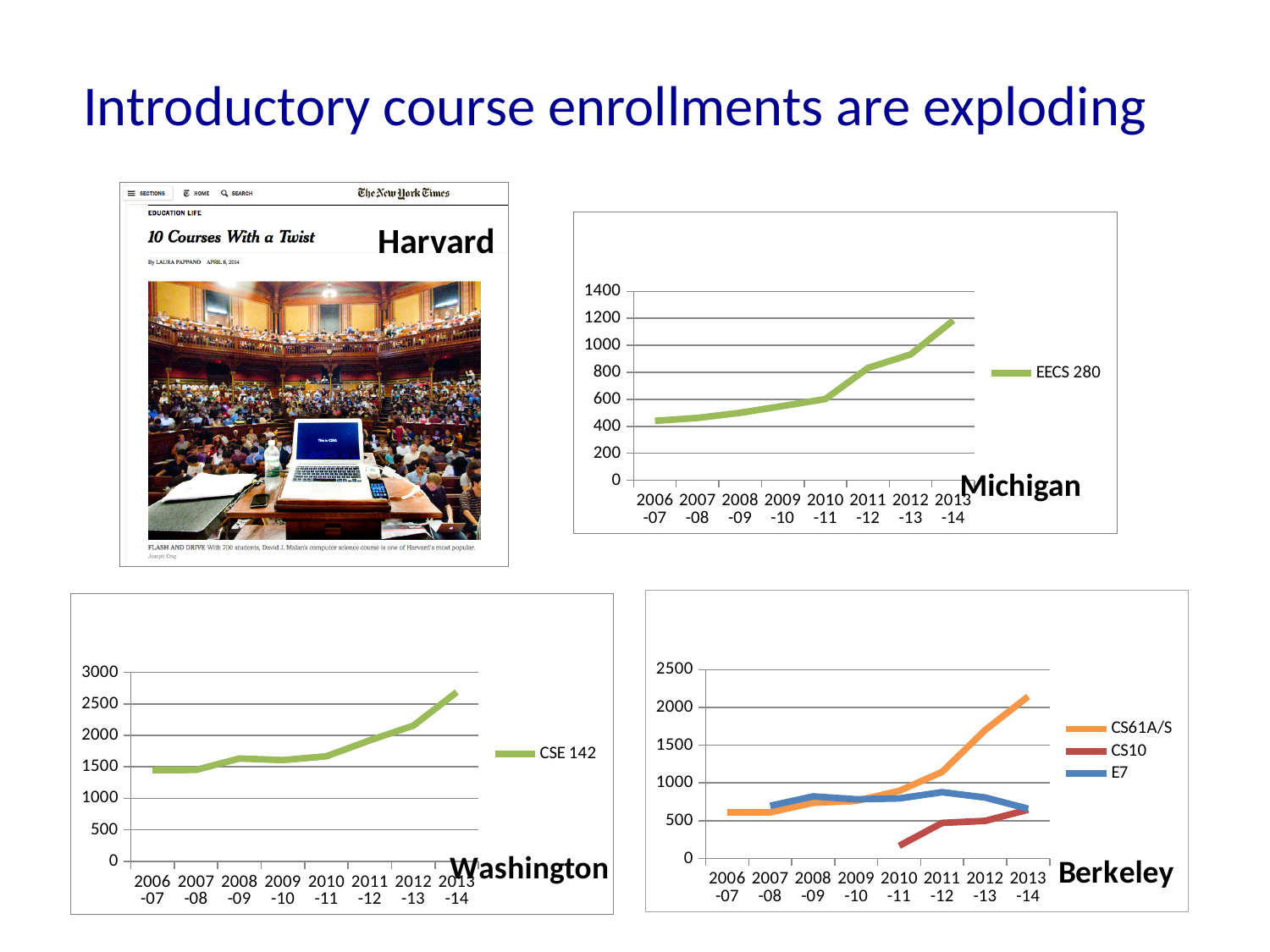
In the Berkeley chart, which is larger in 2013-14: CS61A/S or E7? CS61A/S In the Berkeley chart, is the value for CS61A/S in 2013-14 greater or less than 2000? greater In the Michigan chart, is the value for EECS 280 in 2006-07 greater or less than 600? less In the Washington chart, which series does the legend list? CSE 142 What kind of chart is the Michigan chart? line chart How many series does the legend of the Berkeley chart list? 3 In the Washington chart, which year has the highest CSE 142 enrollment? 2013-14 In the Michigan chart, is the value for EECS 280 in 2013-14 greater or less than 1000? greater In the Berkeley chart, which series has the highest value in 2013-14? CS61A/S How many academic years are shown on the x axis of the Michigan chart? 8 In the Michigan chart, do EECS 280 enrollments rise or fall from 2006-07 to 2013-14? rise